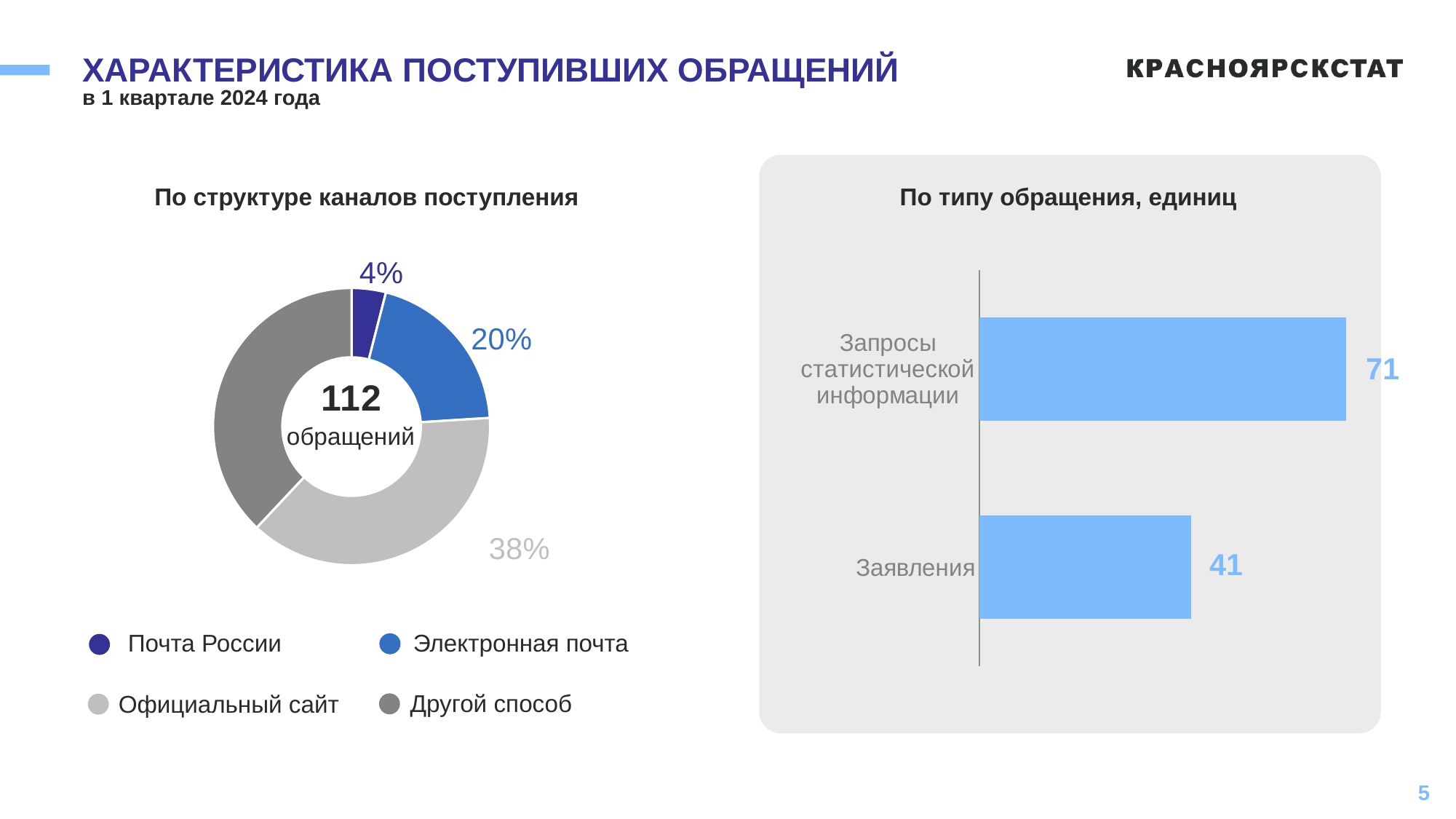
In the chart 'По структуре каналов поступления', what share is shown for 'Электронная почта'? 20% What kind of chart is 'По типу обращения, единиц'? Bar chart In the chart 'По структуре каналов поступления', which is larger: the share for 'Электронная почта' or for 'Почта России'? Электронная почта In the chart 'По структуре каналов поступления', what share is shown for 'Официальный сайт'? 38% In the chart 'По структуре каналов поступления', what share is shown for 'Почта России'? 4% In the chart 'По структуре каналов поступления', which channel has the smallest share? Почта России In the chart 'По типу обращения, единиц', what is the difference between the values for 'Запросы статистической информации' and 'Заявления'? 30 In the chart 'По структуре каналов поступления', how many entries does the legend list? 4 In the chart 'По типу обращения, единиц', which category has the highest value? Запросы статистической информации In the chart 'По типу обращения, единиц', what is the value for 'Заявления'? 41 In the chart 'По типу обращения, единиц', what is the value for 'Запросы статистической информации'? 71 In the chart 'По типу обращения, единиц', how many categories are shown? 2